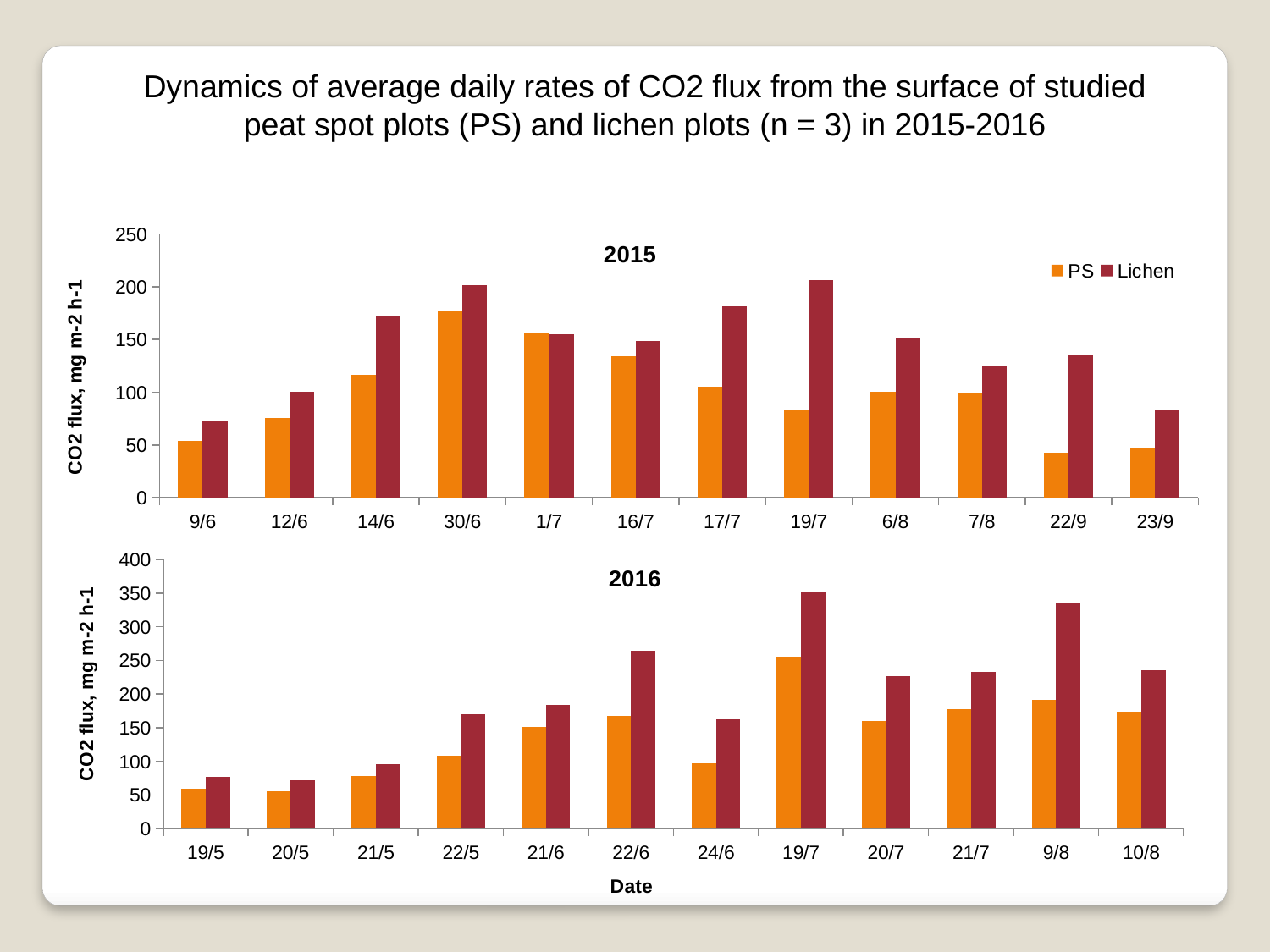
In the 2015 chart, on which date is the PS value lowest? 22/9 In the 2015 chart, is the Lichen value for 19/7 greater or less than 200? greater In the 2016 chart, is the Lichen value for 9/8 greater or less than 300? greater What kind of chart is the 2015 chart? bar chart In the 2015 chart, on which date is the PS value highest? 30/6 In the 2016 chart, on which date is the Lichen value highest? 19/7 What is the y-axis label on the 2016 chart? CO2 flux, mg m-2 h-1 In the 2016 chart, on which date is the PS value lowest? 20/5 In the 2015 chart, on which date is the Lichen value highest? 19/7 In the 2016 chart, which is larger on 22/6, the PS value or the Lichen value? Lichen How many dates are shown on the x axis of the 2016 chart? 12 How many series does the legend on the 2015 chart list? 2